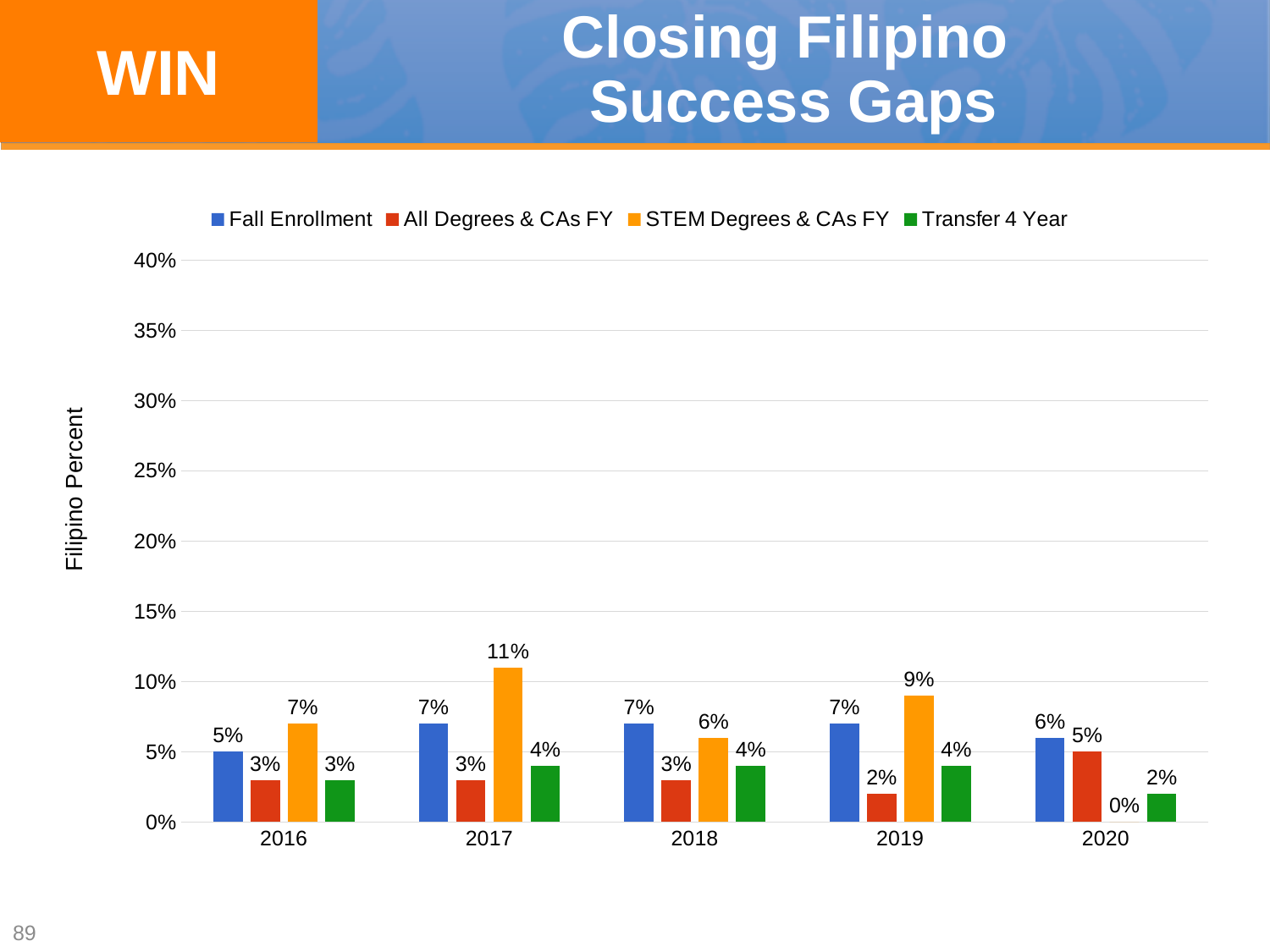
In which year is the STEM Degrees & CAs FY value lowest? 2020 What is the value for All Degrees & CAs FY in 2019? 2% In which year is the STEM Degrees & CAs FY value highest? 2017 What is the value for Fall Enrollment in 2020? 6% What is the label of the vertical axis? Filipino Percent Which is larger in 2018: Fall Enrollment or STEM Degrees & CAs FY? Fall Enrollment What is the value for Transfer 4 Year in 2016? 3% What kind of chart is shown on the slide? Bar chart How many series does the legend list? 4 How many years are shown on the x axis? 5 What is the value for STEM Degrees & CAs FY in 2017? 11% What is the difference between the STEM Degrees & CAs FY value and the Fall Enrollment value in 2019? 2%